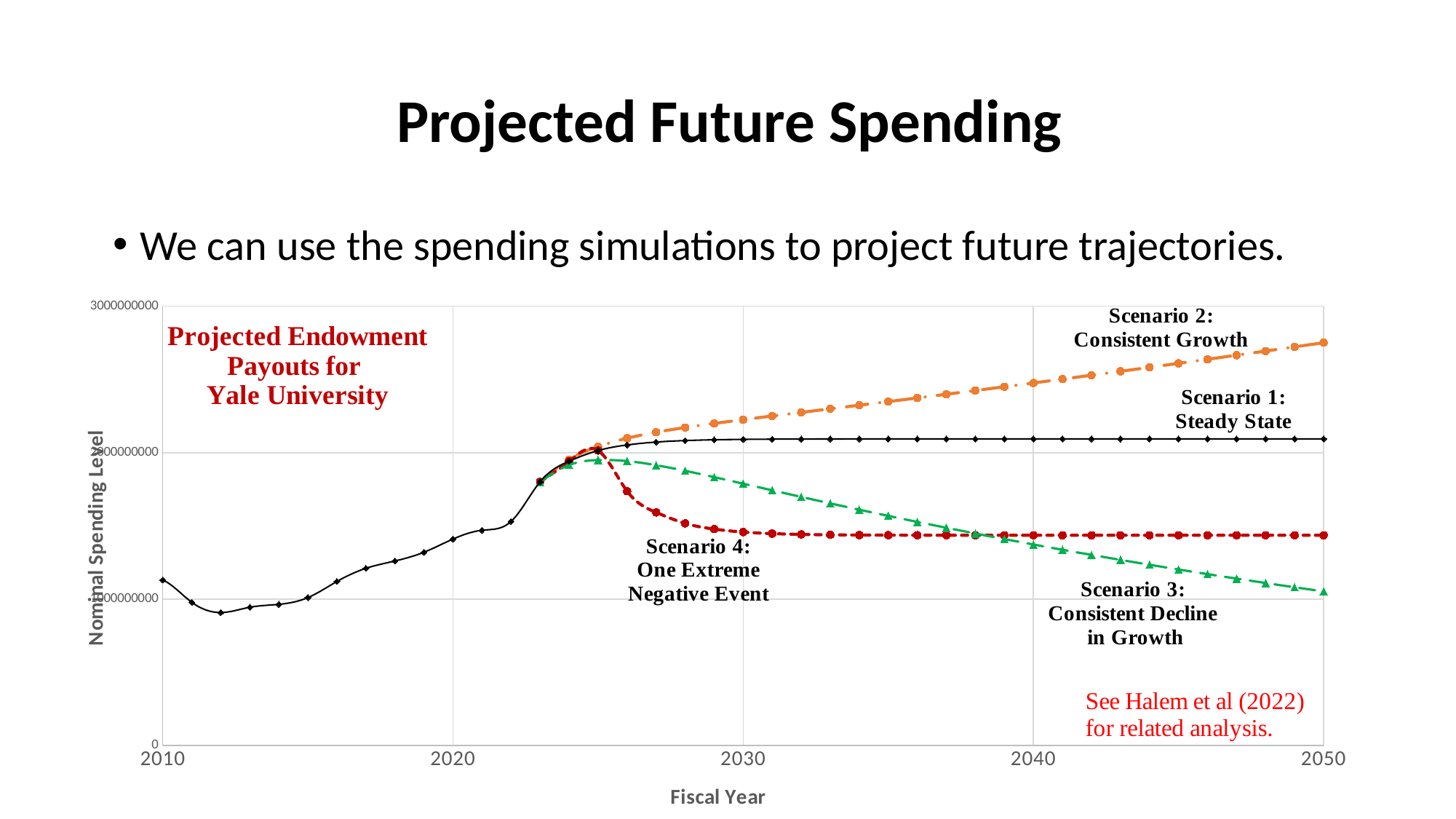
What kind of chart is shown on the slide? line chart Does the Scenario 3 line rise or fall between 2030 and 2050? fall Is the value for Scenario 4 in 2050 greater or less than 2000000000? less Which scenario has the highest spending level in 2050? Scenario 2: Consistent Growth What is the label of the x axis of the chart? Fiscal Year How many projection scenarios are labelled on the chart? 4 What is the title printed inside the chart? Projected Endowment Payouts for Yale University In 2050, which is larger: the value for Scenario 2 or the value for Scenario 4? Scenario 2 Does the Scenario 2 line rise or fall between 2030 and 2050? rise Which scenario has the lowest spending level in 2050? Scenario 3: Consistent Decline in Growth Is the value for Scenario 2 in 2050 greater or less than 2000000000? greater Is the spending level in 2012 greater or less than 1000000000? less